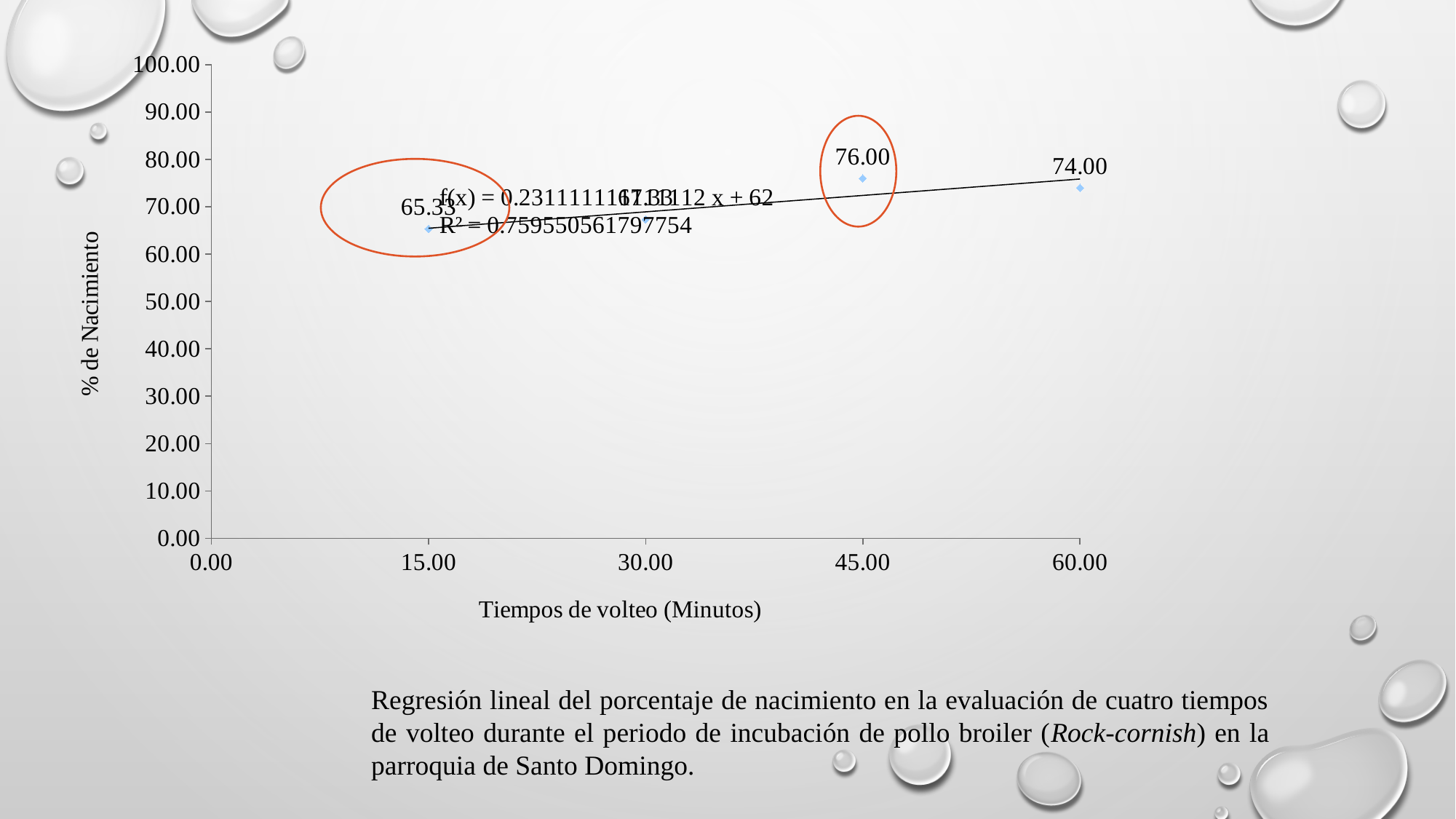
At which turning time (Tiempos de volteo) is the % de Nacimiento lowest? 15.00 What is the % de Nacimiento value at a turning time of 60.00 minutes? 74.00 What is the title of the x axis of the chart? Tiempos de volteo (Minutos) Which turning time has the larger % de Nacimiento, 45.00 or 60.00 minutes? 45.00 What is the difference between the % de Nacimiento at 45.00 minutes and at 60.00 minutes? 2.00 What kind of chart is shown on the slide? scatter chart How many data points are plotted on the chart? 4 What is the % de Nacimiento value at a turning time of 45.00 minutes? 76.00 What is the difference between the % de Nacimiento at 45.00 minutes and at 15.00 minutes? 10.67 Is the % de Nacimiento at 60.00 minutes greater or less than 80.00? less At which turning time (Tiempos de volteo) is the % de Nacimiento highest? 45.00 What is the % de Nacimiento value at a turning time of 15.00 minutes? 65.33